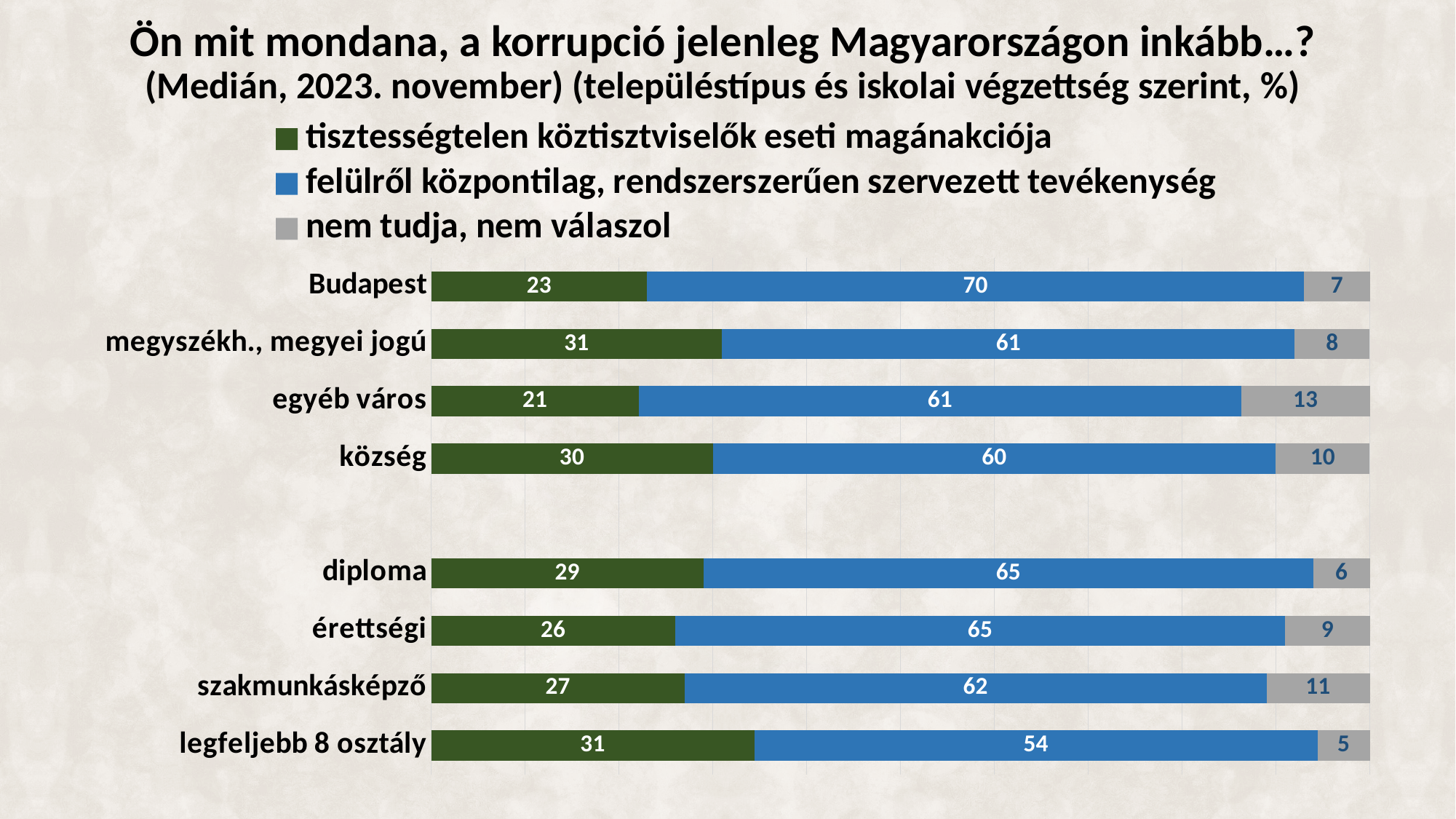
How many categories are shown on the chart? 8 What kind of chart is shown on the slide? stacked bar chart Which is larger: the "nem tudja, nem válaszol" value for egyéb város or for község? egyéb város What is the value for Budapest in the "felülről központilag, rendszerszerűen szervezett tevékenység" series? 70 What is the difference between the "felülről központilag, rendszerszerűen szervezett tevékenység" value and the "tisztességtelen köztisztviselők eseti magánakciója" value for Budapest? 47 What is the value for legfeljebb 8 osztály in the "tisztességtelen köztisztviselők eseti magánakciója" series? 31 What is the value for egyéb város in the "nem tudja, nem válaszol" series? 13 Which category has the lowest value in the "tisztességtelen köztisztviselők eseti magánakciója" series? egyéb város Which category has the lowest value in the "felülről központilag, rendszerszerűen szervezett tevékenység" series? legfeljebb 8 osztály How many series does the legend list? 3 Which category has the highest value in the "felülről központilag, rendszerszerűen szervezett tevékenység" series? Budapest What is the total of the stacked bar for egyéb város? 95